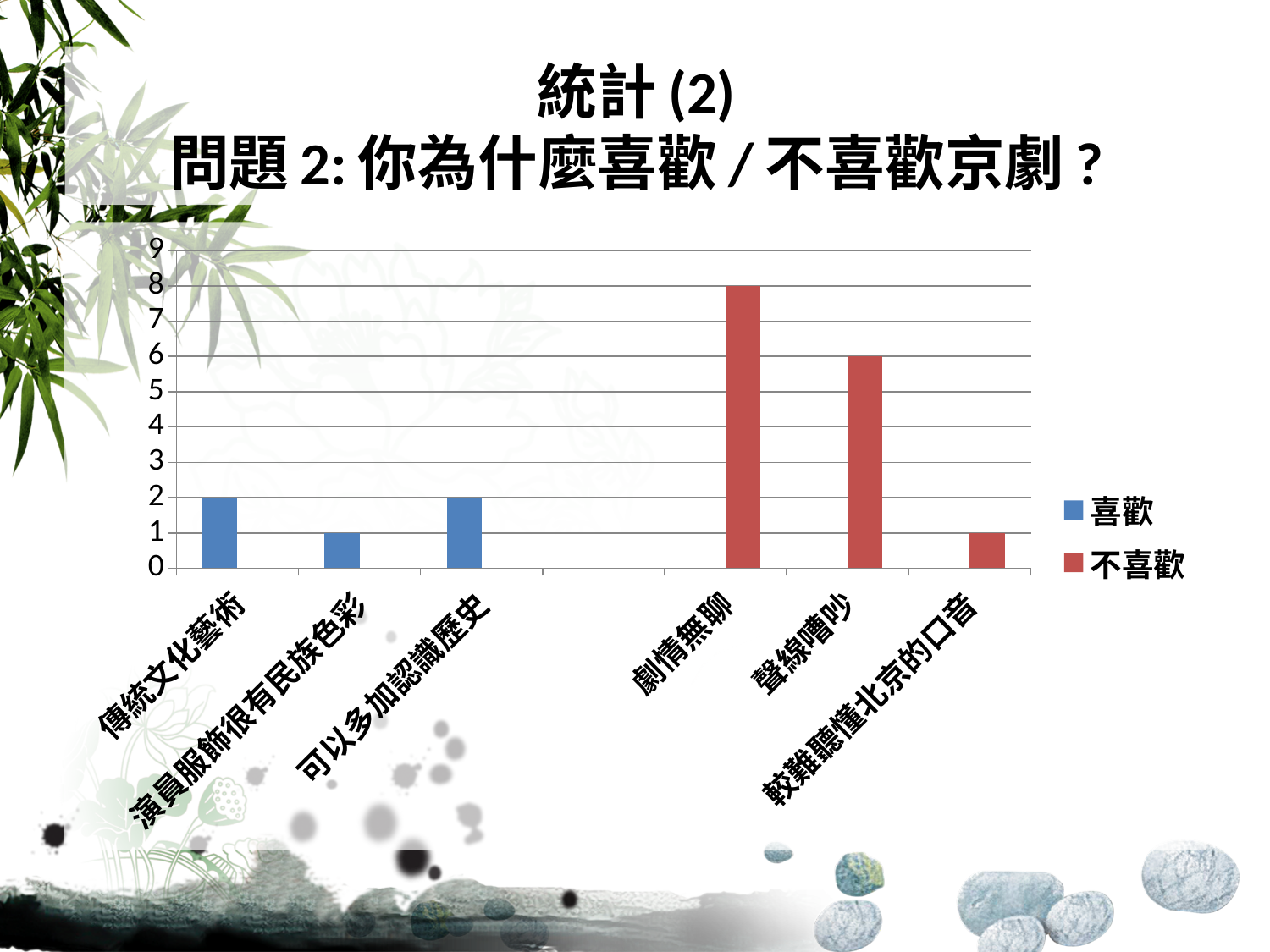
What are the two legend entries? 喜歡, 不喜歡 What is the value for 聲線嘈吵? 6 How many series does the legend list? 2 How many categories are shown on the x axis? 6 Which series do the bars for 劇情無聊, 聲線嘈吵 and 較難聽懂北京的口音 belong to? 不喜歡 What is the difference between the values for 劇情無聊 and 聲線嘈吵? 2 What is the value for 劇情無聊? 8 What kind of chart is shown on the slide? bar chart What is the value for 演員服飾很有民族色彩? 1 Which category has the highest value? 劇情無聊 Is the value for 劇情無聊 greater or less than 5? greater Which is larger, the value for 傳統文化藝術 or the value for 聲線嘈吵? 聲線嘈吵